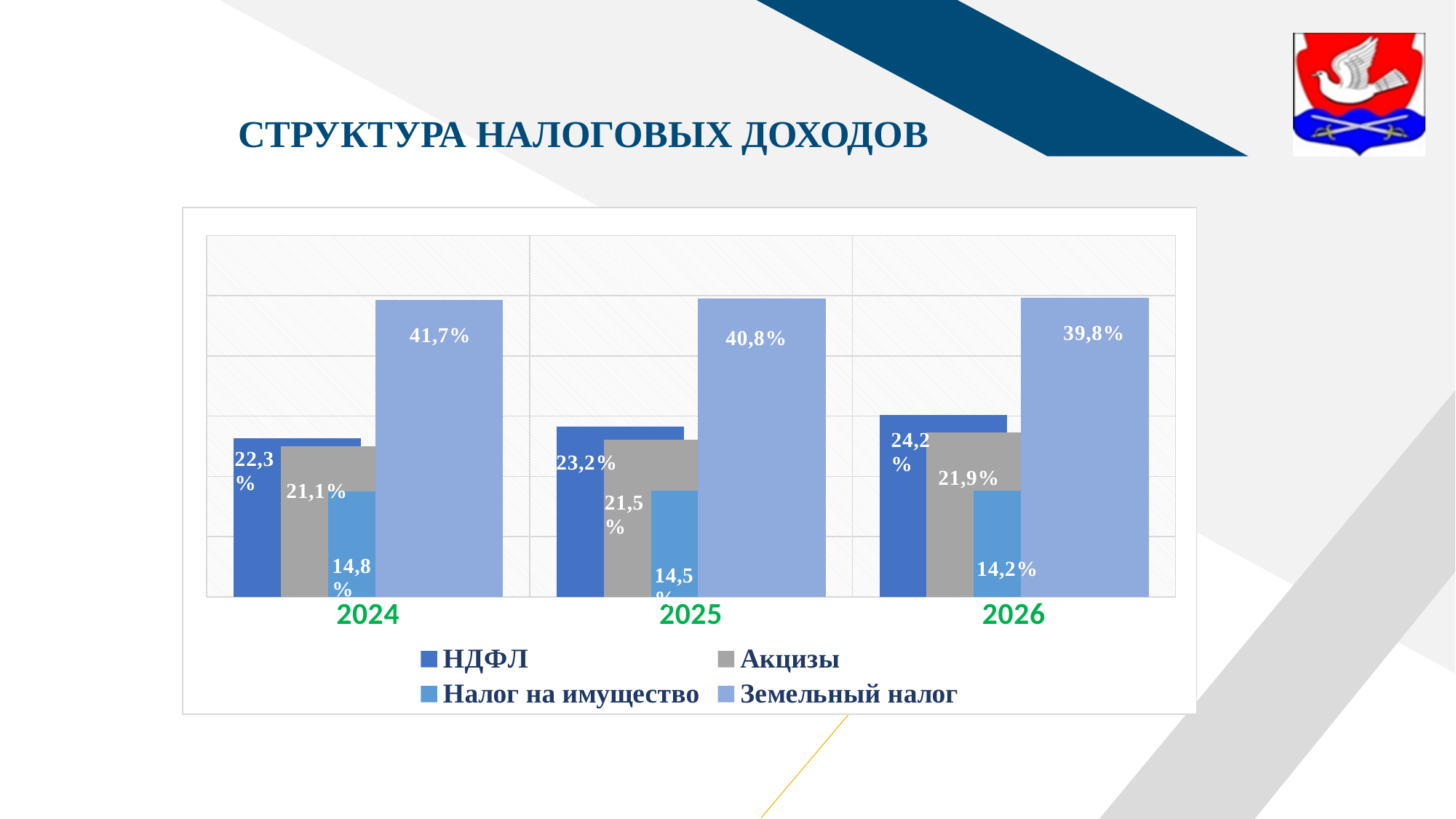
What is the value for НДФЛ in 2026? 24,2% What is the difference between Земельный налог in 2024 and in 2026? 1,9% What kind of chart is shown on the slide? Bar chart What is the value for Земельный налог in 2024? 41,7% Does the value for Земельный налог rise or fall from 2024 to 2026? Fall What is the value for Налог на имущество in 2026? 14,2% How many years are shown on the x axis? 3 How many series does the legend list? 4 Which series has the highest value in 2025? Земельный налог Which is larger: НДФЛ in 2026 or Акцизы in 2026? НДФЛ in 2026 Which series has the lowest value in 2024? Налог на имущество What is the value for Акцизы in 2025? 21,5%